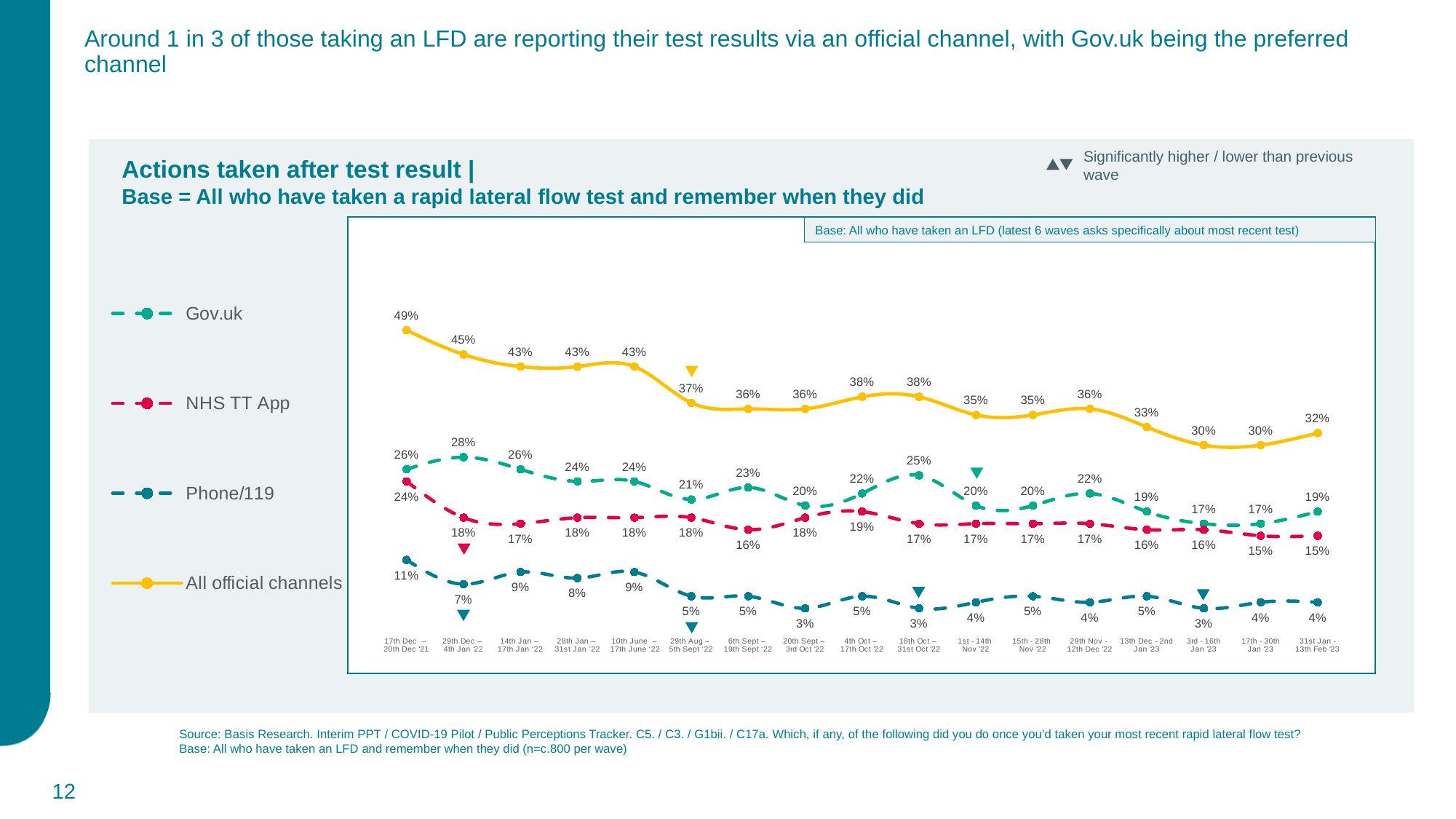
What kind of chart is shown? Line chart How many series does the legend list? 4 What is the value for All official channels in the 17th Dec – 20th Dec '21 wave? 49% In which wave is the All official channels value highest? 17th Dec – 20th Dec '21 What is the value for Phone/119 in the 20th Sept – 3rd Oct '22 wave? 3% Does the All official channels series generally rise or fall from the first wave to the last? Fall How many waves are plotted along the x axis? 17 In the 29th Dec – 4th Jan '22 wave, which is larger: Gov.uk or NHS TT App? Gov.uk What is the value for Gov.uk in the 31st Jan - 13th Feb '23 wave? 19% What is the difference between the All official channels value in the 17th Dec – 20th Dec '21 wave and the 31st Jan - 13th Feb '23 wave? 17 percentage points What colour is the All official channels line? Yellow In which wave is the Gov.uk value highest? 29th Dec – 4th Jan '22